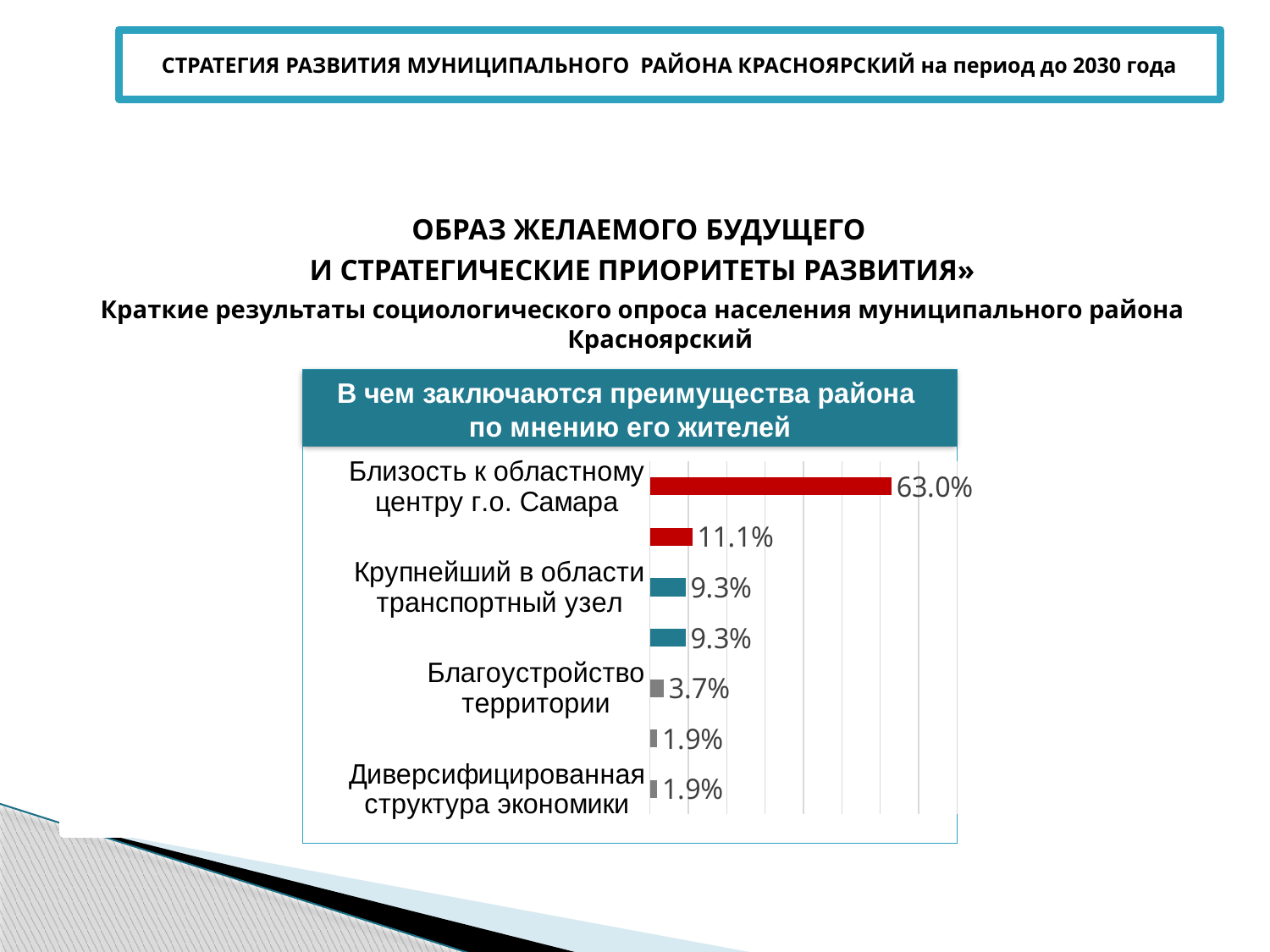
Which is larger: the value for 'Благоустройство территории' or for 'Диверсифицированная структура экономики'? Благоустройство территории What is the value for 'Близость к областному центру г.о. Самара' in the chart? 63.0% What type of chart is shown on the slide? Bar chart What is the value for 'Благоустройство территории'? 3.7% What is the difference between the values for 'Крупнейший в области транспортный узел' and 'Благоустройство территории'? 5.6 percentage points What is the difference between the values for 'Близость к областному центру г.о. Самара' and 'Крупнейший в области транспортный узел'? 53.7 percentage points Which category has the highest value in the chart? Близость к областному центру г.о. Самара What is the value for 'Крупнейший в области транспортный узел'? 9.3% What is the title of the chart? В чем заключаются преимущества района по мнению его жителей What is the value for 'Диверсифицированная структура экономики'? 1.9% What is the lowest value shown in the chart? 1.9% How many bars are plotted in the chart? 7